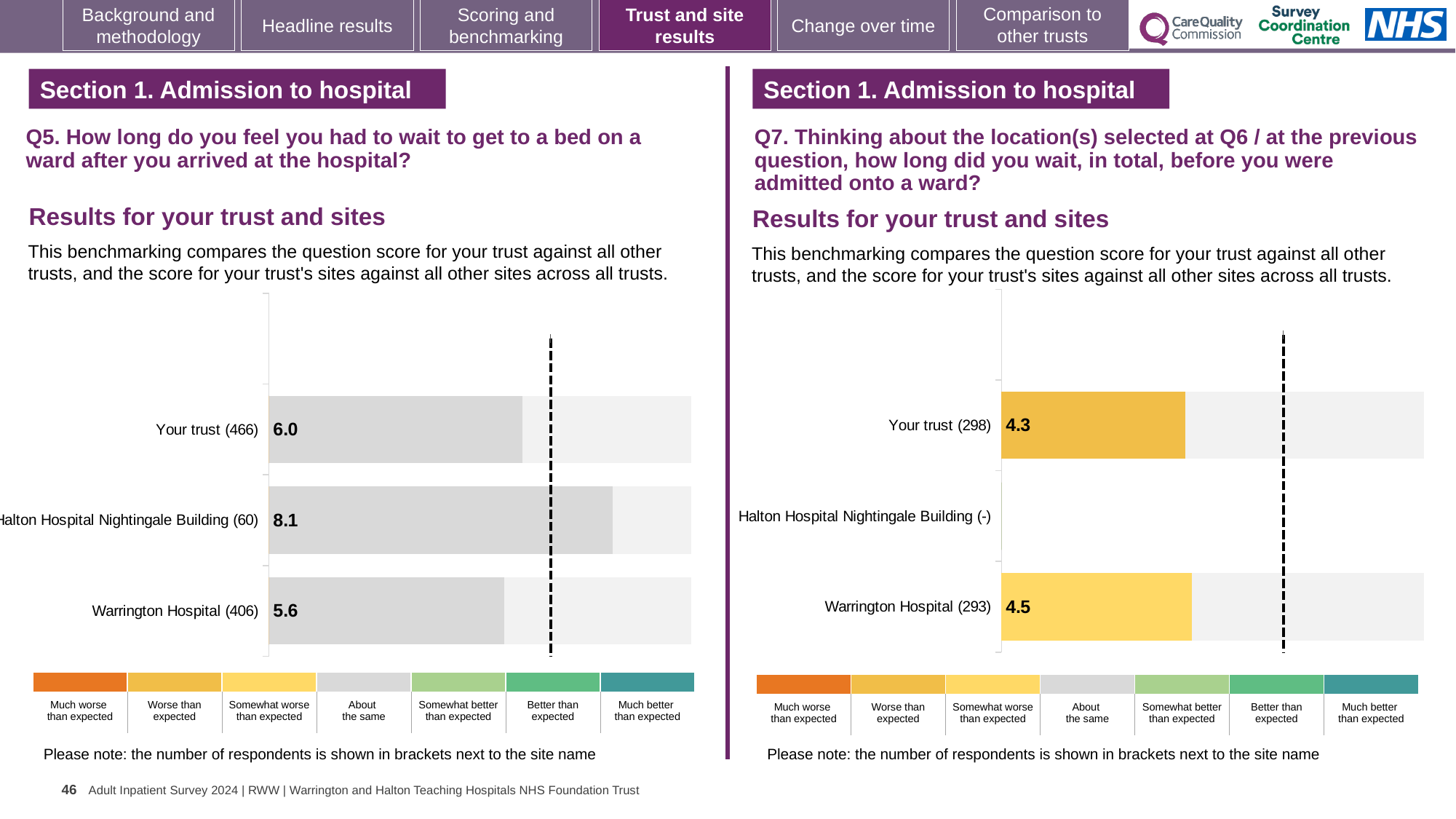
In the Q7 chart on the right, what is the difference between the scores for Warrington Hospital and Your trust? 0.2 In the Q5 chart on the left, which site or trust has the highest score? Halton Hospital Nightingale Building In the Q5 chart on the left, what is the score for Your trust? 6.0 In the Q5 chart on the left, how many respondents are shown in brackets for Your trust? 466 In the Q5 chart on the left, which site or trust has the lowest score? Warrington Hospital In the Q7 chart on the right, which is larger, the score for Your trust or the score for Warrington Hospital? Warrington Hospital What kind of chart is the Q5 chart on the left? Bar chart In the Q7 chart on the right, what is the score for Warrington Hospital? 4.5 In the Q5 chart on the left, what is the difference between the scores for Halton Hospital Nightingale Building and Warrington Hospital? 2.5 In the Q5 chart on the left, what is the score for Halton Hospital Nightingale Building? 8.1 In the Q5 chart on the left, what is the score for Warrington Hospital? 5.6 In the Q7 chart on the right, what is the score for Your trust? 4.3